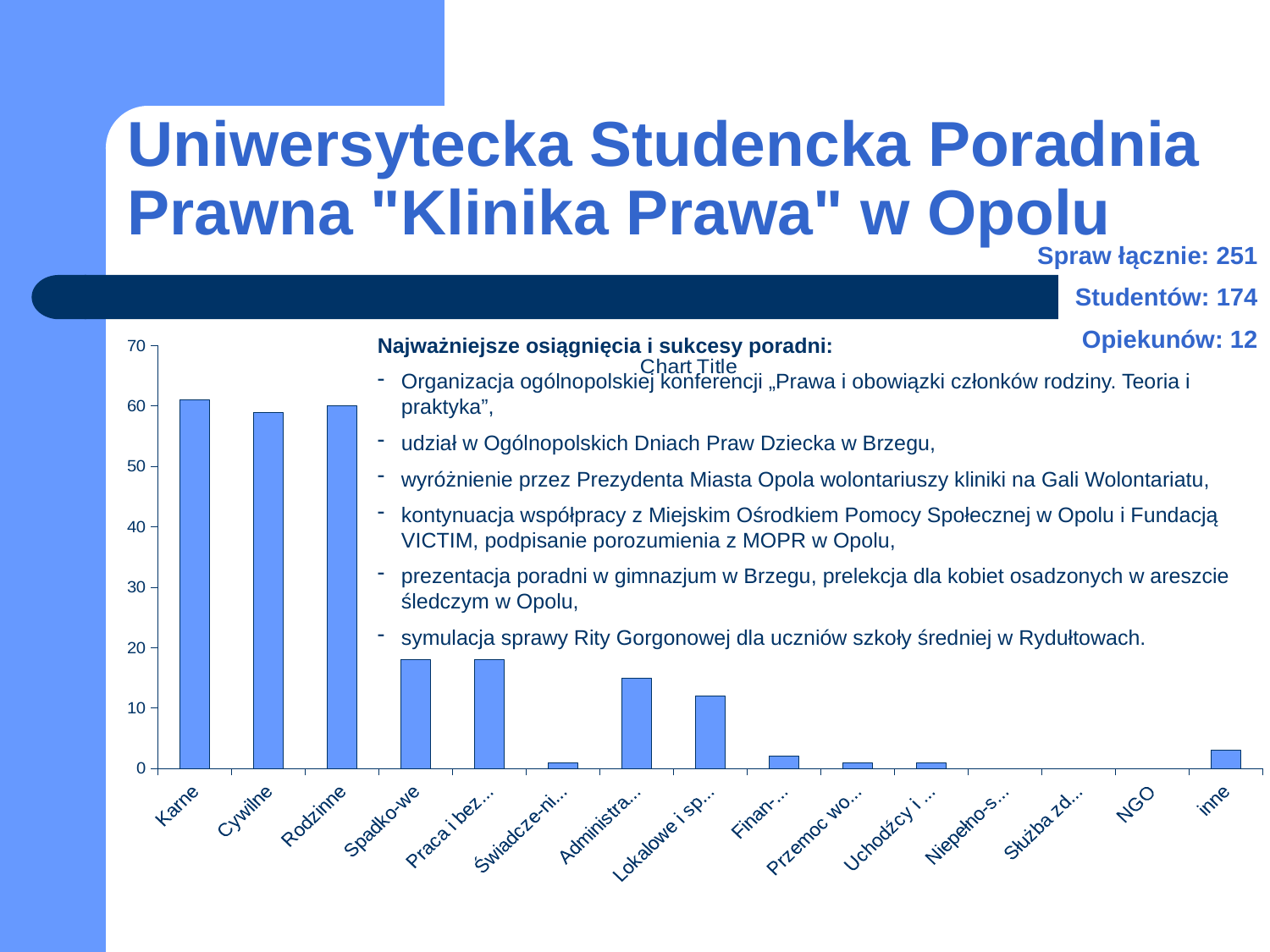
What kind of chart is shown on the slide? bar chart Is the value for Spadko-we greater or less than 20? less Which is larger, the value for Administra... or the value for Finan-...? Administra... Is the value for Karne greater or less than 50? greater Is the value for inne greater or less than 10? less Which is larger, the value for Karne or the value for Spadko-we? Karne What is the title shown on the chart? Chart Title How many categories are shown on the x axis of the chart? 15